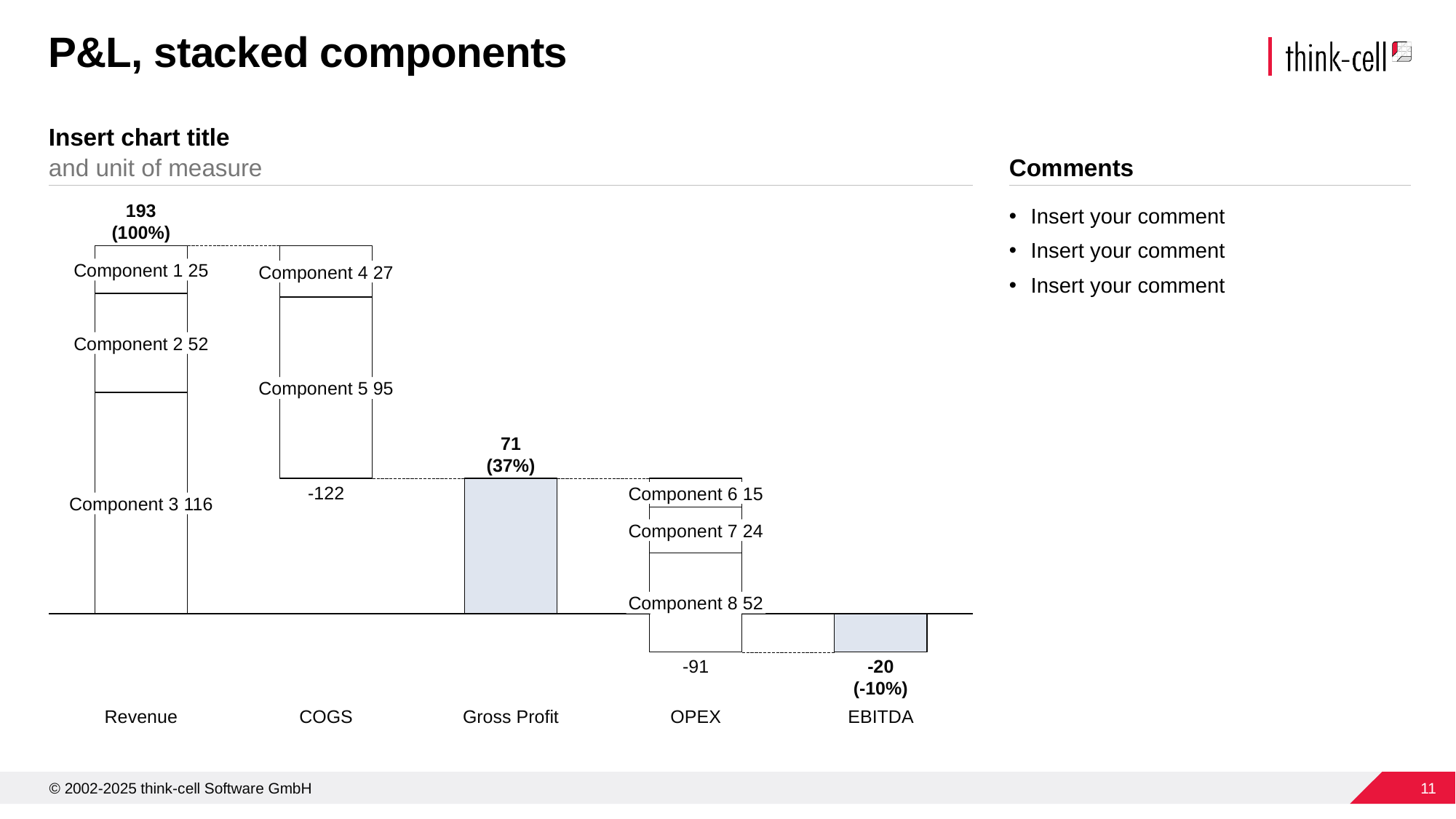
What is the value shown for EBITDA? -20 What is the value shown for COGS? -122 What is the value of Component 5 in the COGS bar? 95 How many categories are shown along the x axis? 5 What is the value of Component 3 in the Revenue bar? 116 What is the total value shown for Revenue? 193 What percentage is shown for Gross Profit? 37% Which component in the Revenue bar is the largest? Component 3 What is the difference between Component 2 and Component 1 in the Revenue bar? 27 What is the value of Component 8 in the OPEX bar? 52 What is the value shown for Gross Profit? 71 What kind of chart is shown on the slide? waterfall chart